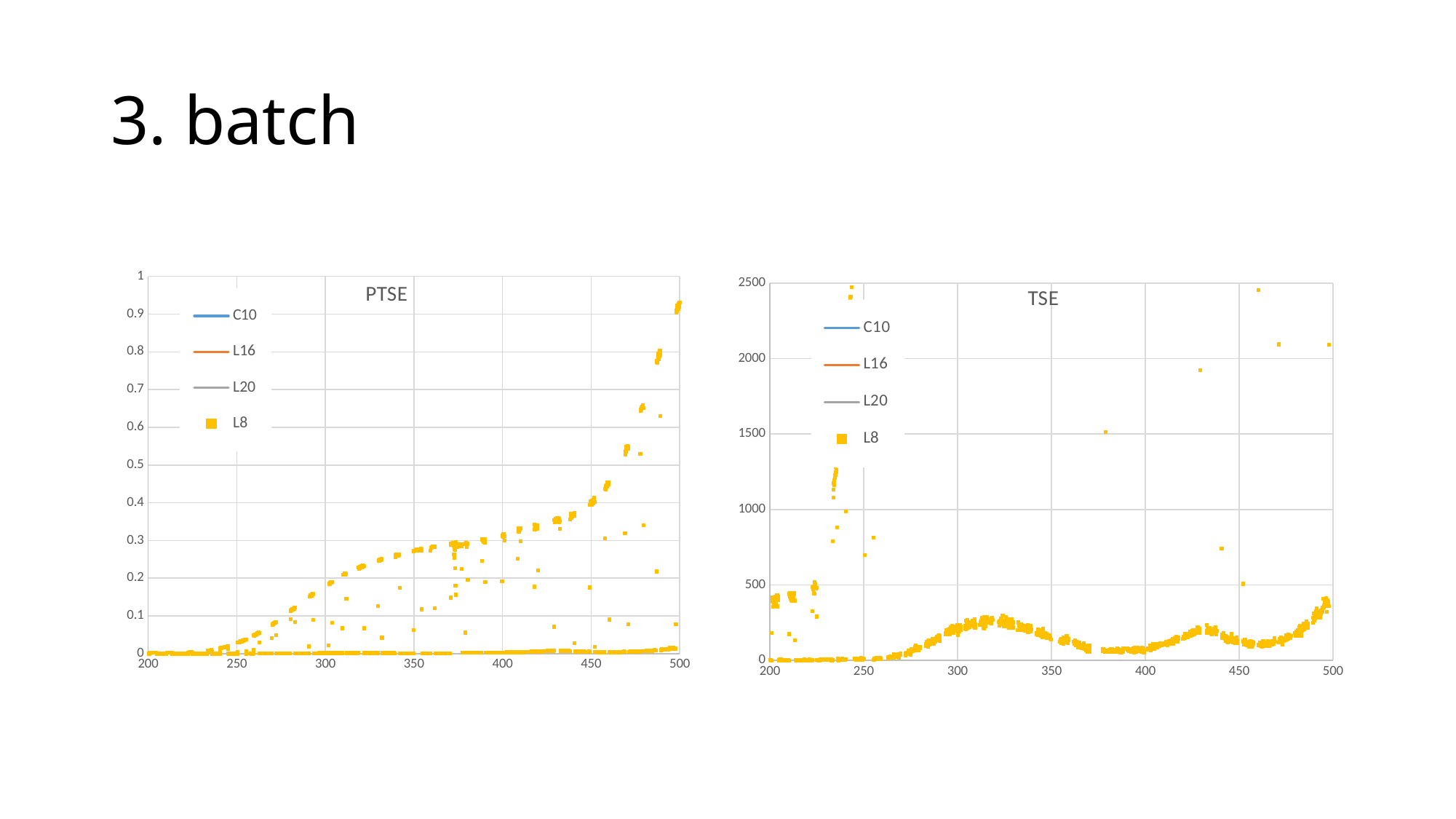
How many series does the legend of the PTSE chart list? 4 In the PTSE chart, are the L8 values near x = 250 greater or less than 0.1? less What kind of chart is the TSE chart? scatter chart In the PTSE chart, is the highest L8 value near x = 500 greater or less than 0.5? greater In the TSE chart, are the highest L8 points near x = 240 greater or less than 2000? greater How many series does the legend of the TSE chart list? 4 In the PTSE chart, which series is plotted with yellow square markers? L8 In the PTSE chart, does the upper band of L8 points rise or fall as x increases from 300 to 500? rise What is the maximum value shown on the y axis of the TSE chart? 2500 What is the title of the chart on the right side of the slide? TSE What kind of chart is the PTSE chart? scatter chart